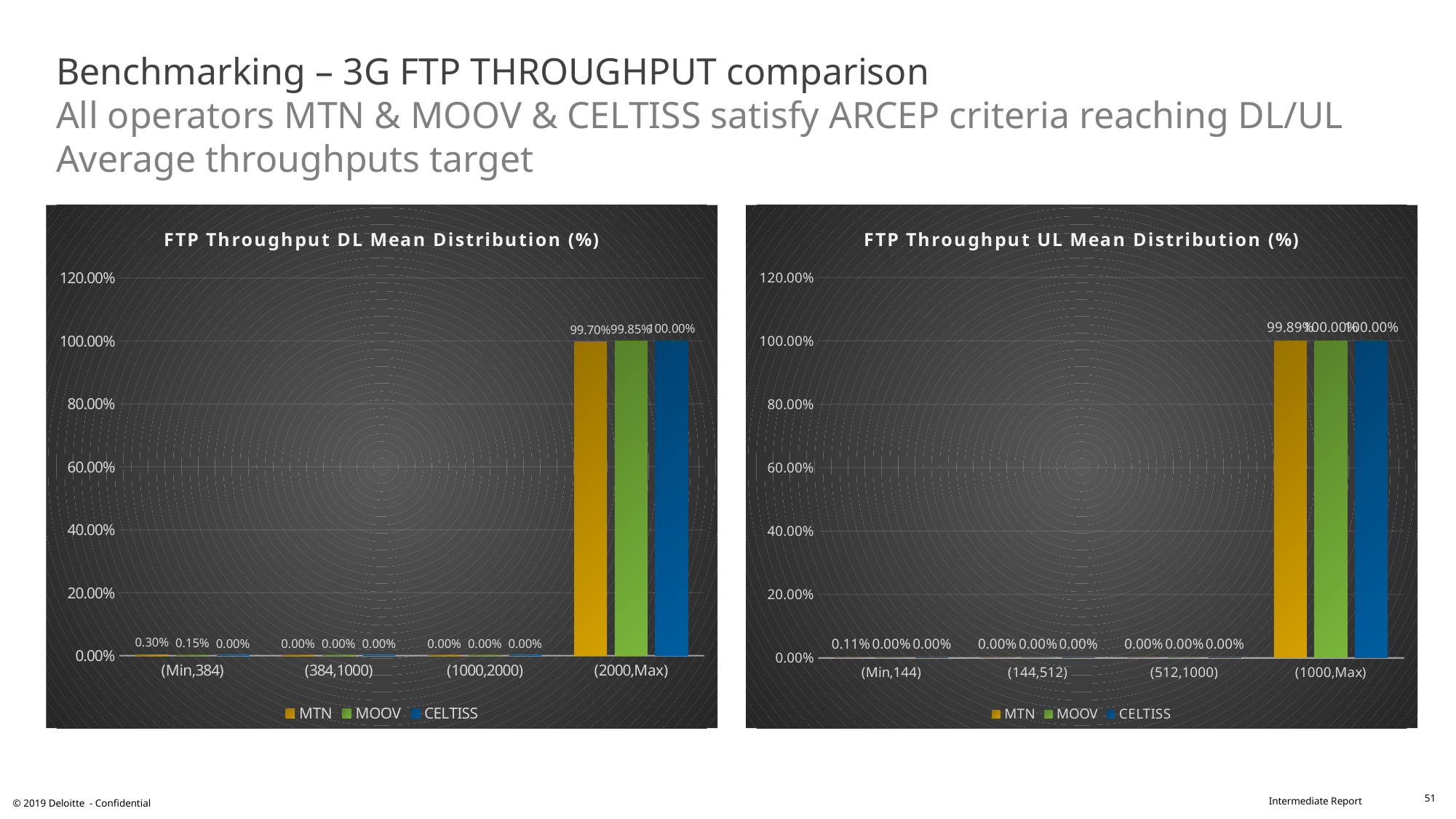
In the FTP Throughput UL Mean Distribution (%) chart, what is the value for MTN in the (Min,144) category? 0.11% In the FTP Throughput DL Mean Distribution (%) chart, what is the difference between the MTN and MOOV values in the (Min,384) category? 0.15% In the FTP Throughput DL Mean Distribution (%) chart, what is the value for MTN in the (2000,Max) category? 99.70% In the FTP Throughput DL Mean Distribution (%) chart, what is the difference between the CELTISS and MTN values in the (2000,Max) category? 0.30% In the FTP Throughput DL Mean Distribution (%) chart, which colour represents CELTISS in the legend? Blue In the FTP Throughput DL Mean Distribution (%) chart, what is the value for MTN in the (Min,384) category? 0.30% How many categories are shown on the x axis of the FTP Throughput DL Mean Distribution (%) chart? 4 In the FTP Throughput UL Mean Distribution (%) chart, which category has the highest values for all three operators? (1000,Max) In the FTP Throughput UL Mean Distribution (%) chart, what is the value for MTN in the (1000,Max) category? 99.89% In the FTP Throughput DL Mean Distribution (%) chart, what is the value for MOOV in the (2000,Max) category? 99.85% What type of chart is the FTP Throughput UL Mean Distribution (%) chart? Bar chart How many series does the legend of the FTP Throughput UL Mean Distribution (%) chart list? 3